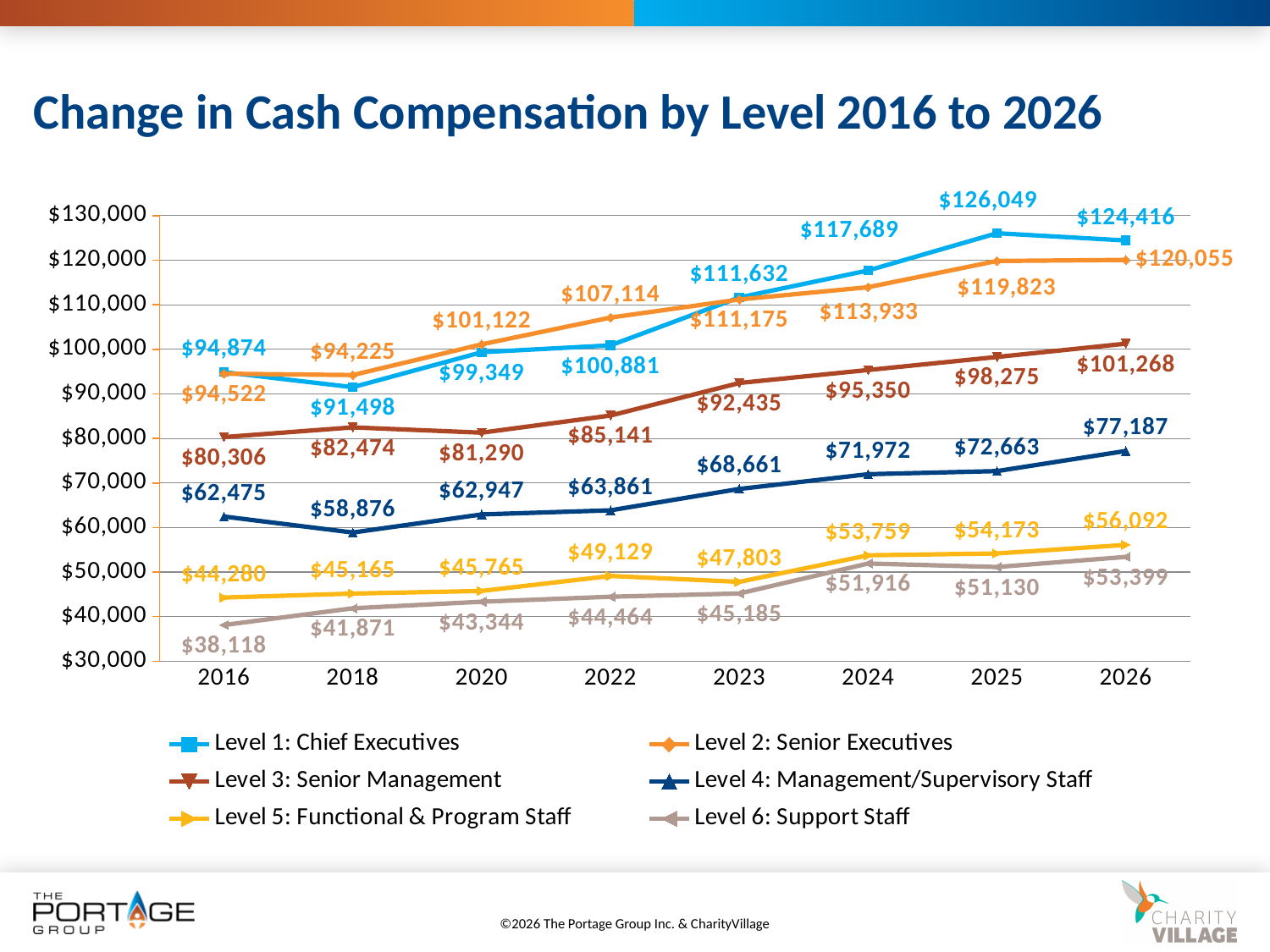
What kind of chart is shown on the slide? Line chart In which year is the value for Level 4: Management/Supervisory Staff lowest? 2018 Which is larger in 2026: Level 1: Chief Executives or Level 2: Senior Executives? Level 1: Chief Executives What is the cash compensation for Level 6: Support Staff in 2016? $38,118 What is the cash compensation for Level 3: Senior Management in 2022? $85,141 How many series does the legend list? 6 In which year is the value for Level 1: Chief Executives highest? 2025 What is the cash compensation for Level 1: Chief Executives in 2025? $126,049 How many years are shown on the x axis? 8 What is the difference between the 2026 and 2016 values for Level 2: Senior Executives? $25,533 Does the value for Level 3: Senior Management rise or fall from 2022 to 2026? Rise What is the cash compensation for Level 5: Functional & Program Staff in 2024? $53,759